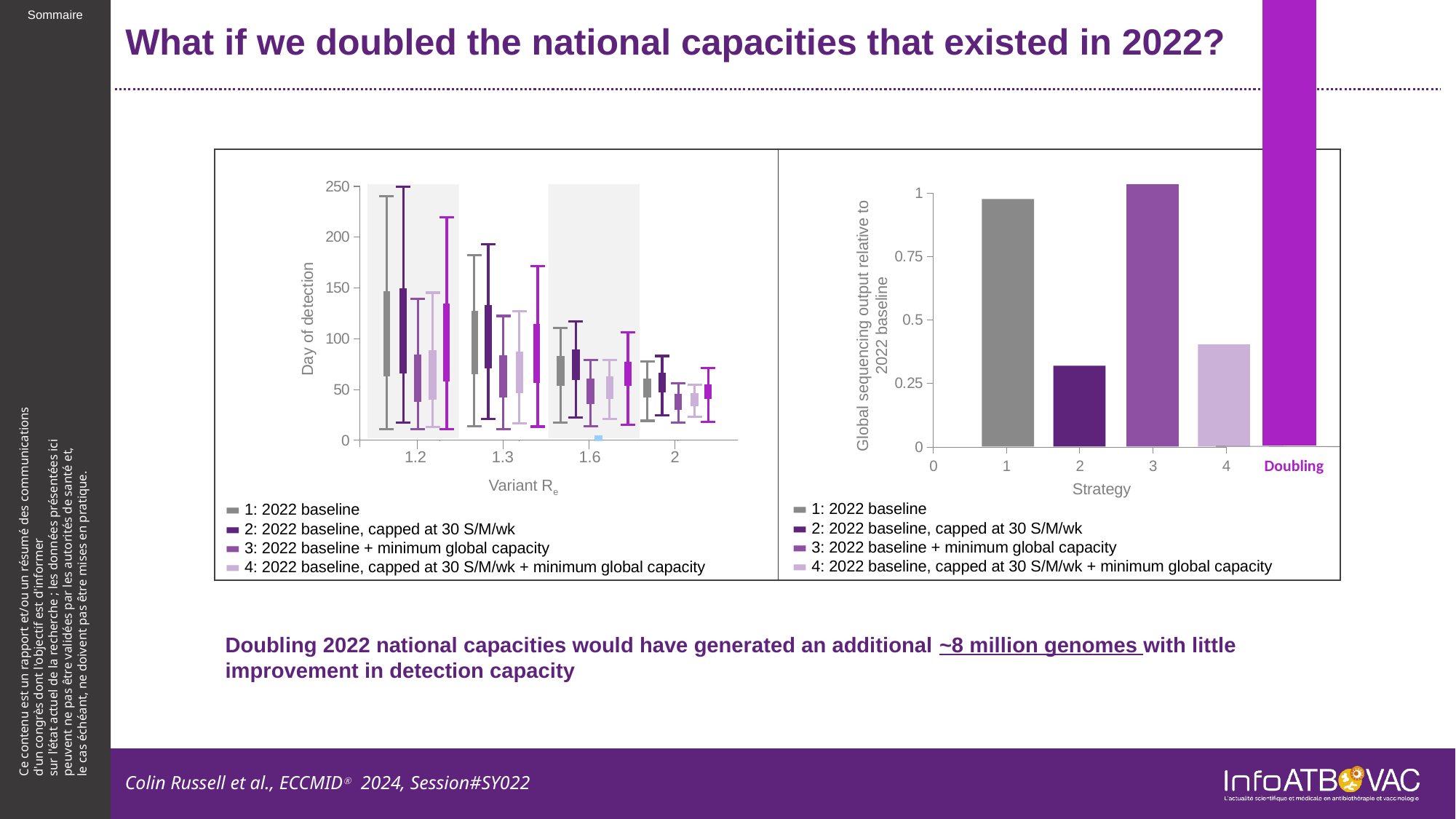
What kind of chart is the right-hand chart titled with the y-axis 'Global sequencing output relative to 2022 baseline'? bar chart In the left-hand chart, how many Variant Re categories are shown on the x axis? 4 In the right-hand bar chart, which is larger: the value for strategy 3 or the value for strategy 4? strategy 3 In the left-hand chart, what is the label of the y axis? Day of detection In the right-hand bar chart, is the value for strategy 1 greater or less than 0.75? greater In the right-hand bar chart, which strategy has the highest global sequencing output relative to the 2022 baseline? Doubling In the right-hand bar chart, what is the label of the x axis? Strategy How many series does the legend of the right-hand bar chart list? 4 In the left-hand chart, does the day of detection for the 2022 baseline series generally rise or fall as Variant Re increases? fall In the right-hand bar chart, which numbered strategy has the lowest global sequencing output relative to the 2022 baseline? 2 In the right-hand bar chart, is the value for strategy 2 greater or less than 0.5? less In the right-hand bar chart, is the value for strategy 4 greater or less than 0.5? less